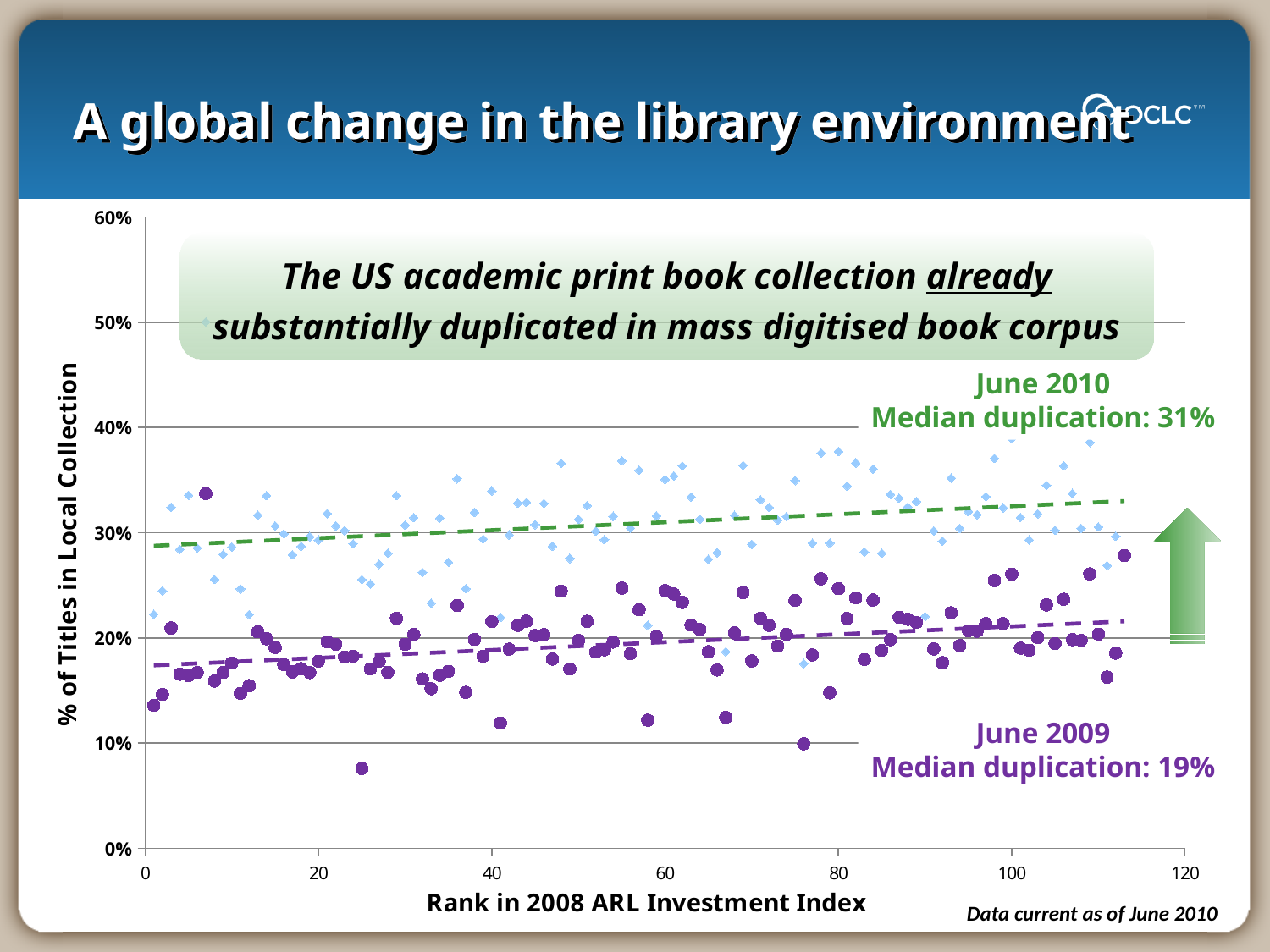
Which series has the higher median duplication, June 2010 or June 2009? June 2010 Do the dashed trend lines rise or fall as rank increases along the x axis? rise Is the June 2009 median duplication greater or less than 20%? less Is the June 2010 median duplication greater or less than 30%? greater What is the label of the y axis? % of Titles in Local Collection What is the median duplication for June 2010? 31% By how many percentage points does the June 2010 median duplication exceed the June 2009 median duplication? 12 percentage points What is the median duplication for June 2009? 19% What kind of chart is shown on the slide? scatter chart What is the highest value shown on the y axis? 60% What is the label of the x axis? Rank in 2008 ARL Investment Index How many data series are plotted on the chart? 2